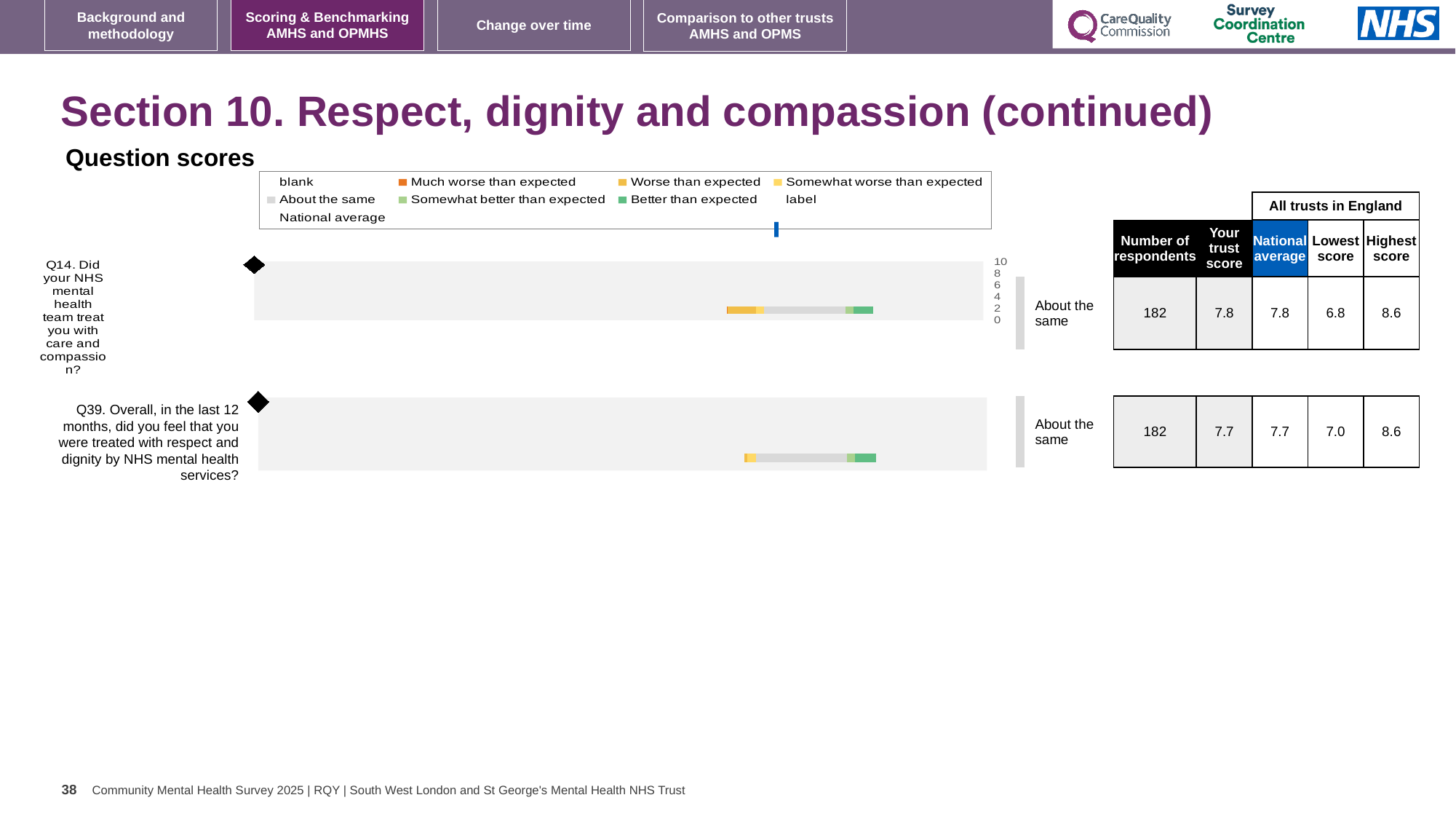
Which question has the higher trust score, Q14 or Q39? Q14 What is the lowest score among all trusts in England for Q14? 6.8 What is the difference between the highest and lowest scores for Q14 across all trusts in England? 1.8 Which legend entry is shown in dark orange? Much worse than expected What is the benchmark category shown next to the bar for Q39? About the same What kind of chart is used to show the question scores? Bar chart What is the highest score among all trusts in England for Q39? 8.6 What is the trust score for Q39 (treated with respect and dignity by NHS mental health services)? 7.7 What is the national average score for Q39? 7.7 What is the trust score for Q14 (Did your NHS mental health team treat you with care and compassion?)? 7.8 How many questions are plotted in the chart? 2 How many respondents answered Q14? 182